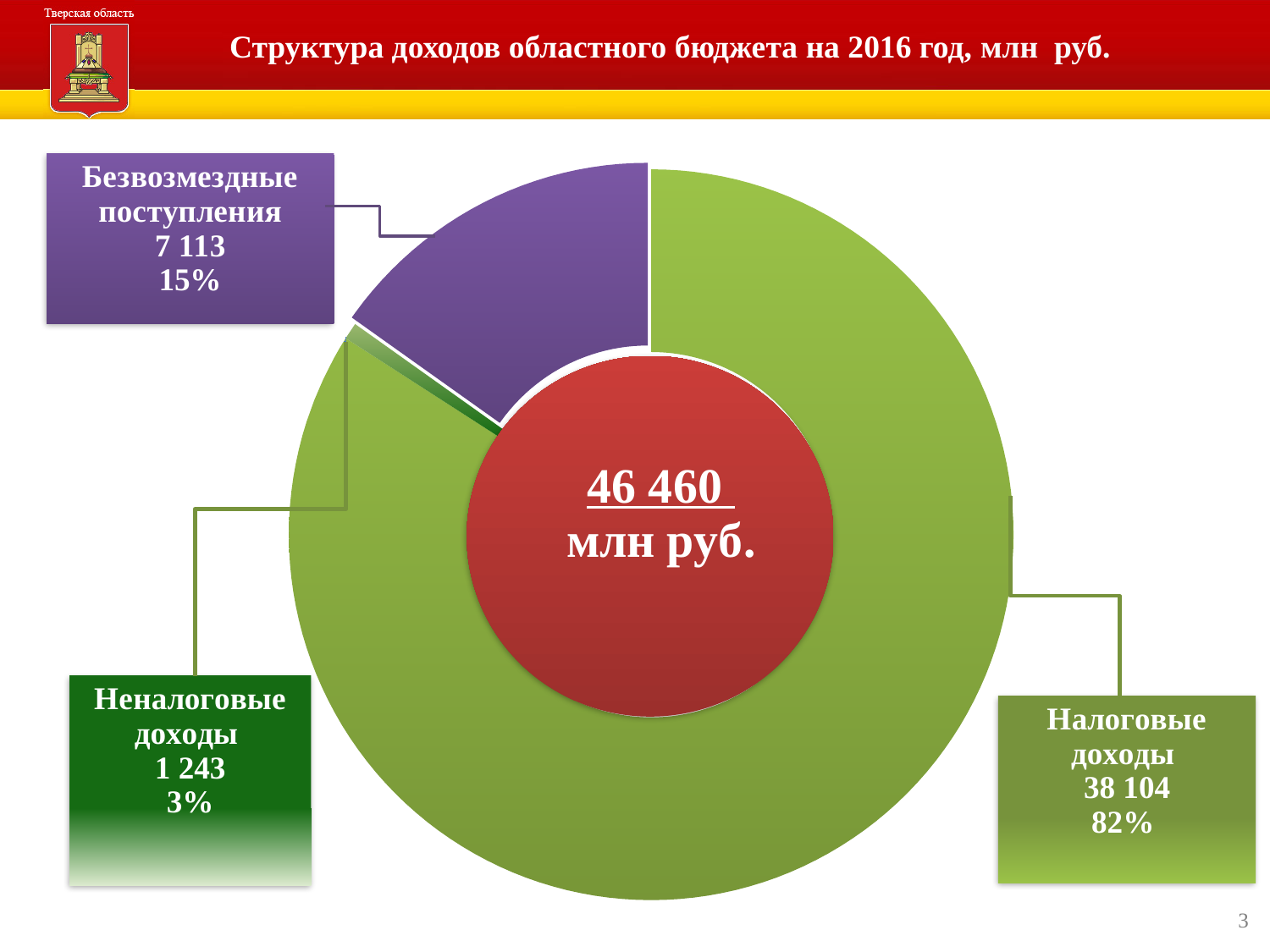
Which is larger, Безвозмездные поступления or Неналоговые доходы? Безвозмездные поступления What share of the budget revenue do Безвозмездные поступления make up? 15% What is the total shown in the centre of the chart? 46 460 млн руб. What is the value for Неналоговые доходы? 1 243 How many categories does the chart show? 3 What is the value for Налоговые доходы? 38 104 Which category has the smallest value? Неналоговые доходы What share of the budget revenue do Неналоговые доходы make up? 3% Which category has the largest value? Налоговые доходы What share of the budget revenue do Налоговые доходы make up? 82% What is the value for Безвозмездные поступления? 7 113 What is the difference between Налоговые доходы and Безвозмездные поступления? 30 991